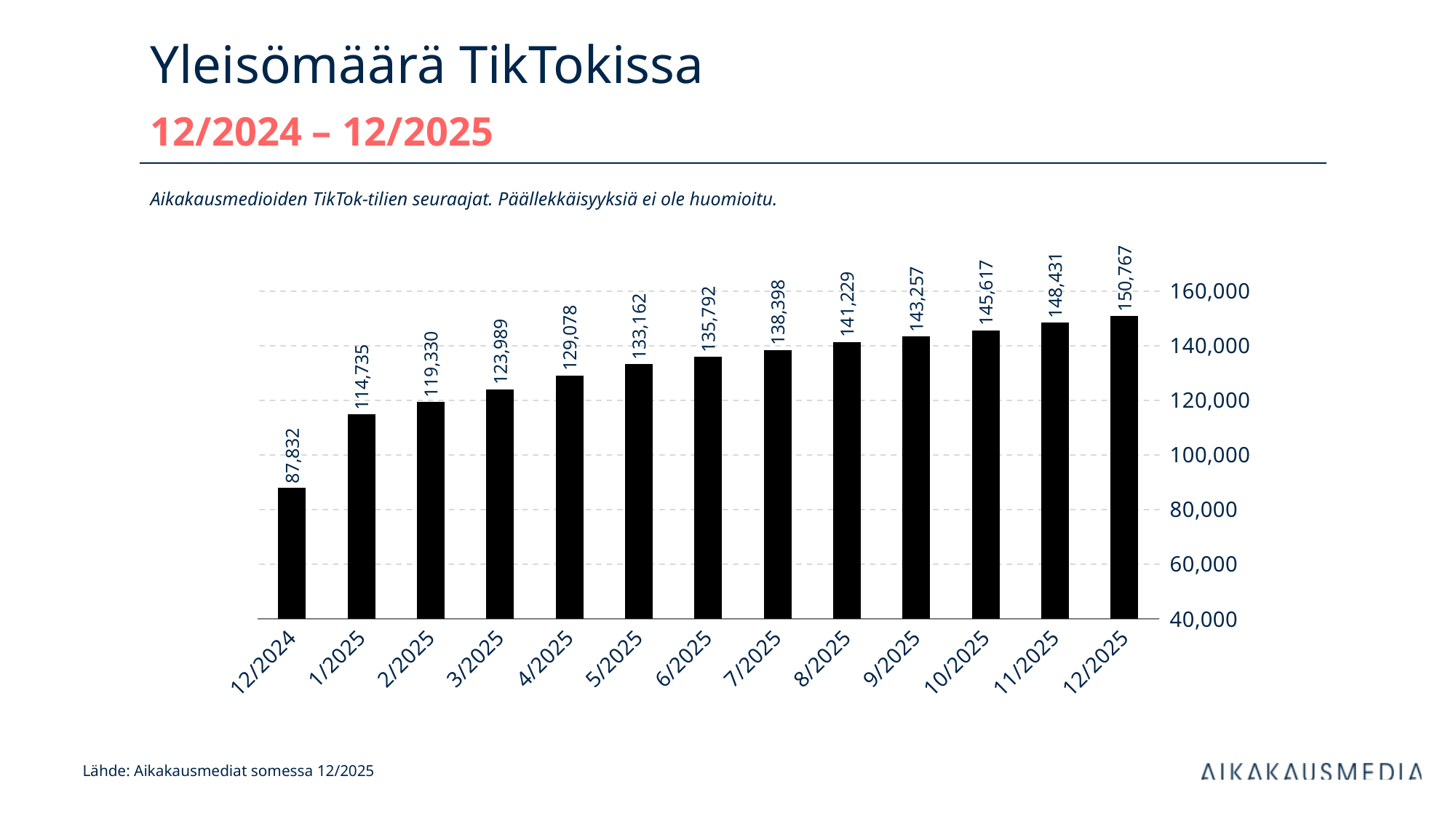
Is the value for 4/2025 greater or less than 120,000? greater Which is larger, the value for 3/2025 or the value for 9/2025? 9/2025 What is the difference between the values for 2/2025 and 1/2025? 4,595 How many months are shown on the x axis? 13 Which month has the lowest value? 12/2024 What is the difference between the values for 12/2025 and 12/2024? 62,935 What is the value for 6/2025? 135,792 Which month has the highest value? 12/2025 Do the values rise or fall from 12/2024 to 12/2025? rise What is the value for 12/2024? 87,832 What kind of chart is shown on the slide? bar chart What is the value for 12/2025? 150,767